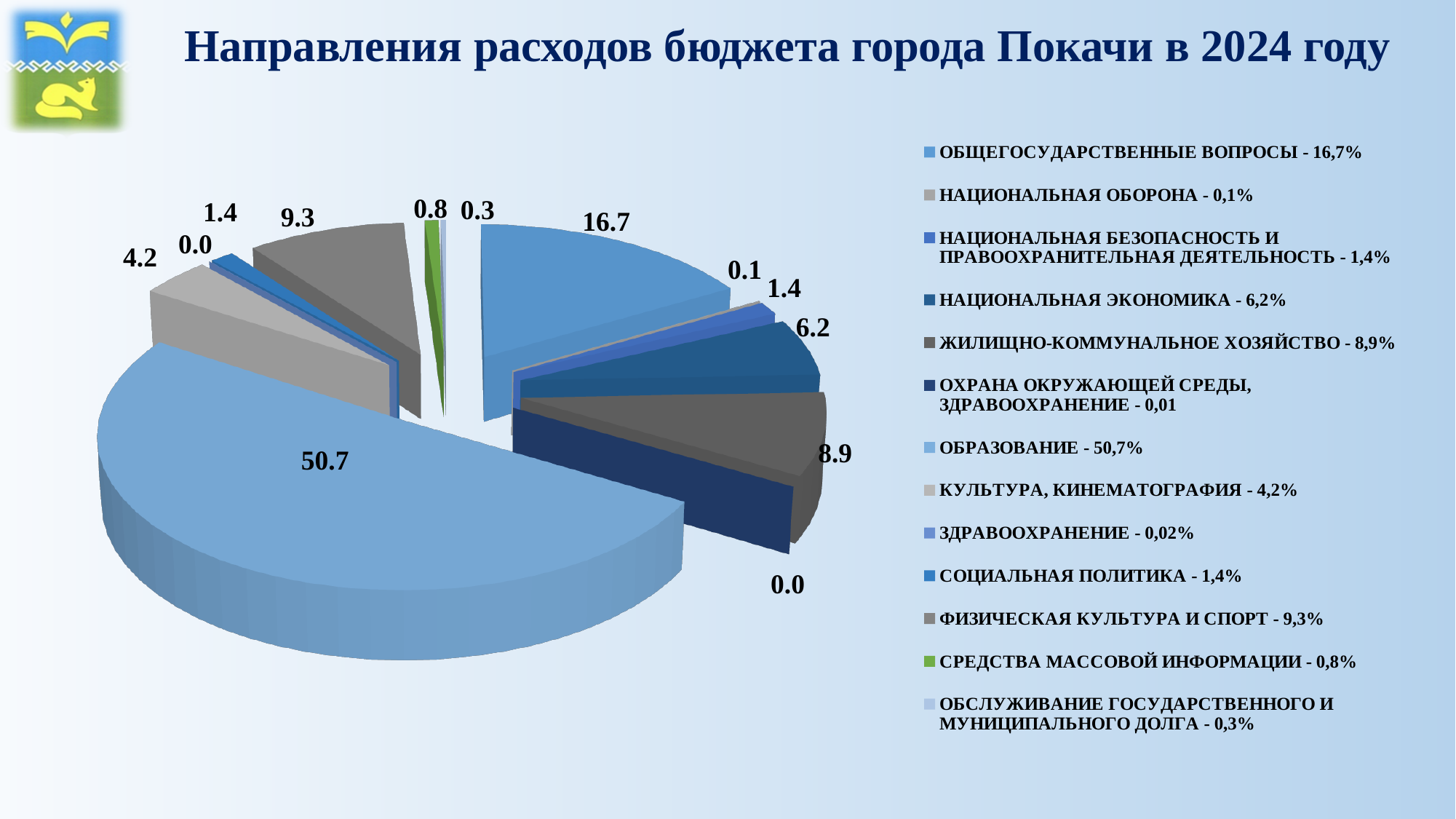
What data label is shown on the slice for ОБЩЕГОСУДАРСТВЕННЫЕ ВОПРОСЫ? 16.7 What is the difference between the data labels for ОБРАЗОВАНИЕ and ОБЩЕГОСУДАРСТВЕННЫЕ ВОПРОСЫ? 34.0 What data label is shown on the slice for ФИЗИЧЕСКАЯ КУЛЬТУРА И СПОРТ? 9.3 What data label is shown on the slice for ОБРАЗОВАНИЕ? 50.7 How many categories does the legend of the pie chart list? 13 What is the title of the slide? Направления расходов бюджета города Покачи в 2024 году Which slice is larger: ЖИЛИЩНО-КОММУНАЛЬНОЕ ХОЗЯЙСТВО or НАЦИОНАЛЬНАЯ ЭКОНОМИКА? ЖИЛИЩНО-КОММУНАЛЬНОЕ ХОЗЯЙСТВО What share of the budget expenditures does ОБРАЗОВАНИЕ account for, according to the legend? 50,7% What type of chart is shown on the slide? pie chart What percentage does the legend give for КУЛЬТУРА, КИНЕМАТОГРАФИЯ? 4,2% Which category has the largest slice of the pie chart? ОБРАЗОВАНИЕ What data label is shown on the slice for СРЕДСТВА МАССОВОЙ ИНФОРМАЦИИ? 0.8